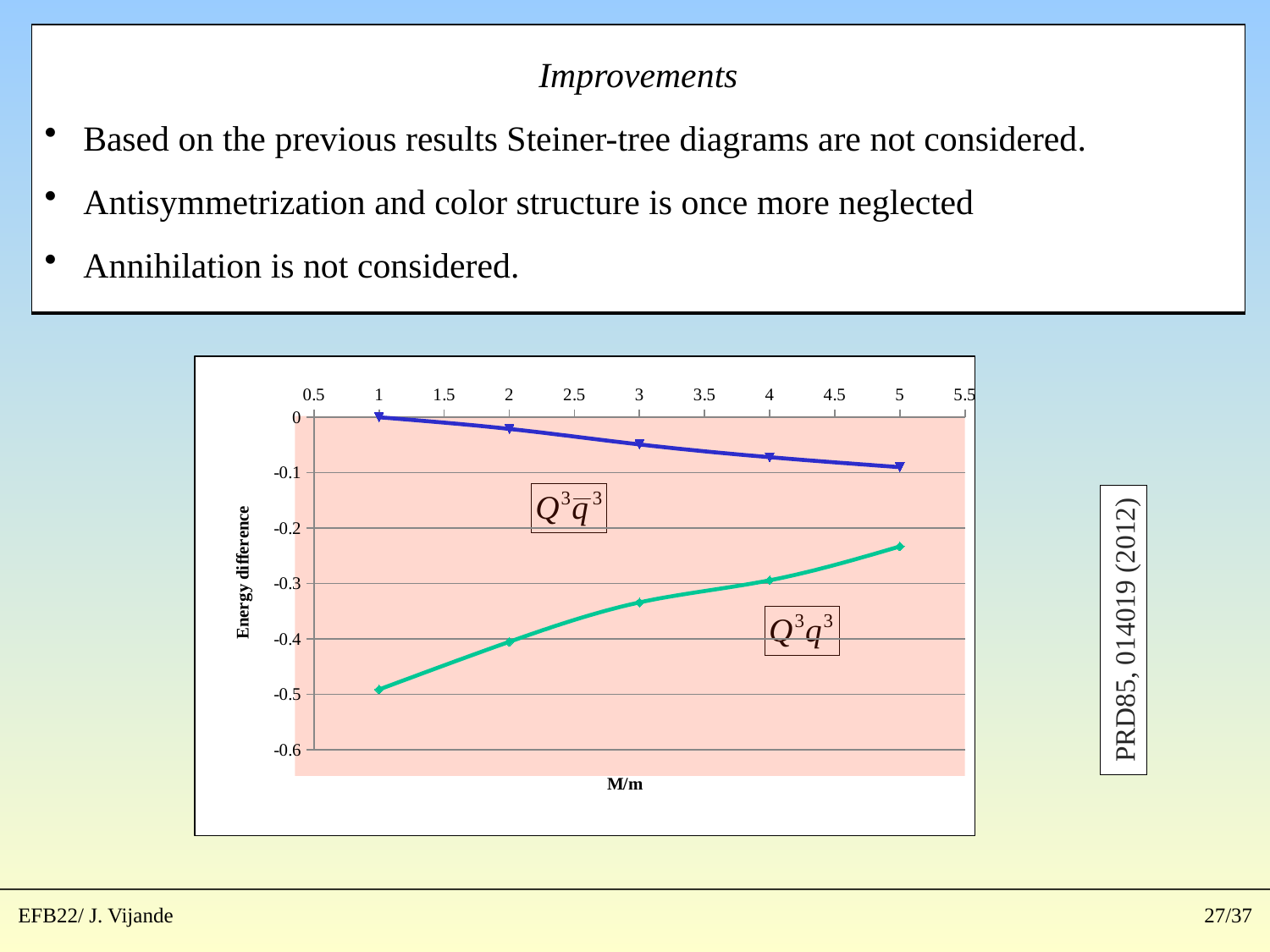
Is the value of the Q³q̄³ series at M/m = 3 greater or less than -0.1? greater Is the value of the Q³q³ series at M/m = 5 greater or less than -0.3? greater Is the value of the Q³q³ series at M/m = 1 greater or less than -0.4? less Does the Q³q³ series rise or fall as M/m increases? rise What is the label of the y axis of the chart? Energy difference At which value of M/m does the Q³q³ series reach its lowest energy difference? 1 How many data points does the Q³q³ series have? 5 At M/m = 3, which series has the larger energy difference, Q³q̄³ or Q³q³? Q³q̄³ How many data series are plotted on the chart? 2 Does the Q³q̄³ series rise or fall as M/m increases? fall What is the label of the x axis of the chart? M/m What kind of chart is shown on the slide? line chart